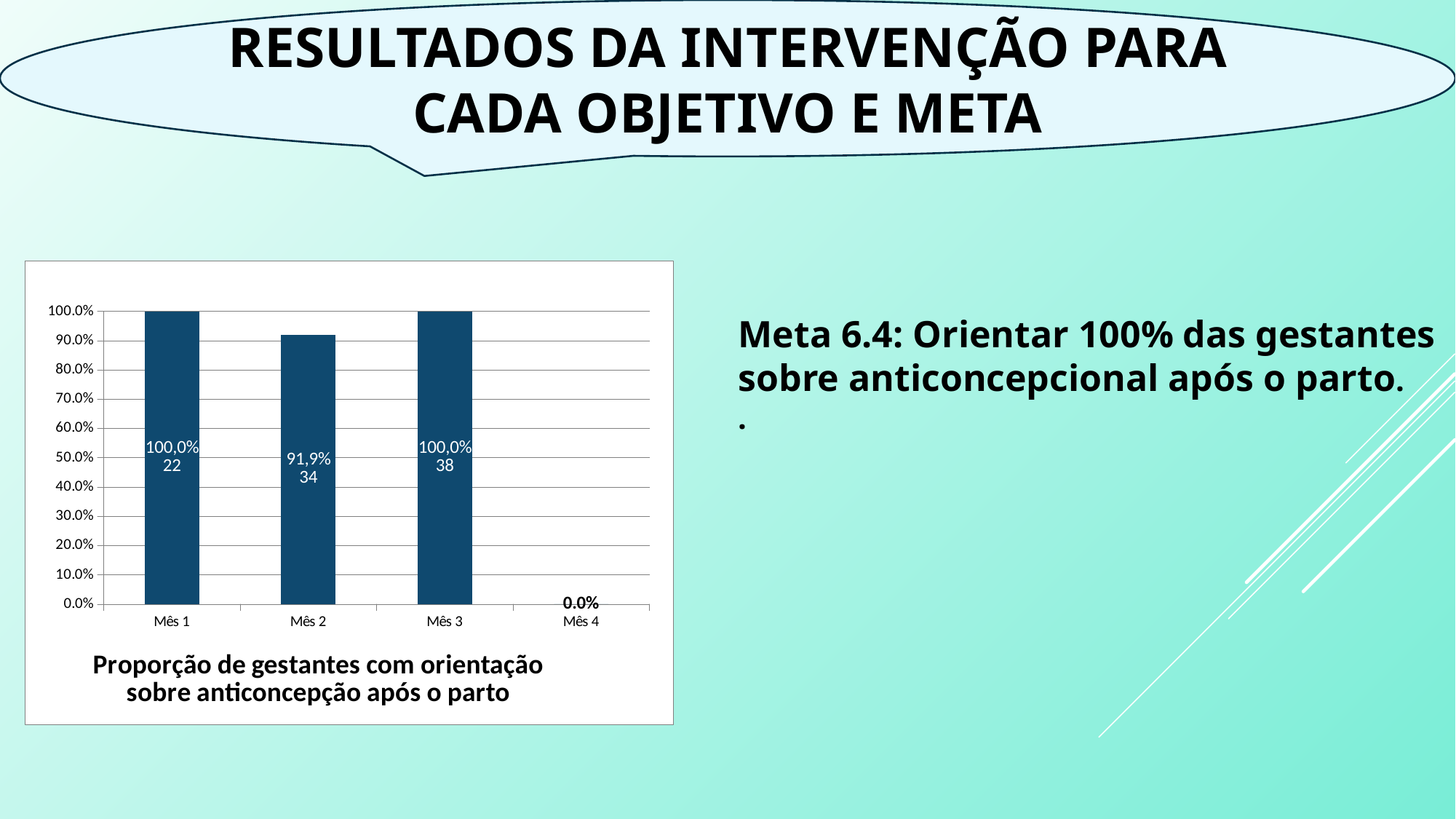
What is the title of the chart? Proporção de gestantes com orientação sobre anticoncepção após o parto What is the value shown for Mês 4? 0.0% What count is printed inside the bar for Mês 3? 38 Which month has the lowest value in the chart? Mês 4 What kind of chart is shown on the slide? bar chart What is the percentage shown for Mês 2? 91,9% What count is printed inside the bar for Mês 2? 34 What is the difference in percentage points between Mês 1 and Mês 2? 8,1 How many months (categories) are shown on the x axis? 4 Which is larger, the percentage for Mês 2 or for Mês 3? Mês 3 What is the percentage shown for Mês 1? 100,0% Is the value for Mês 2 greater or less than 80.0%? greater